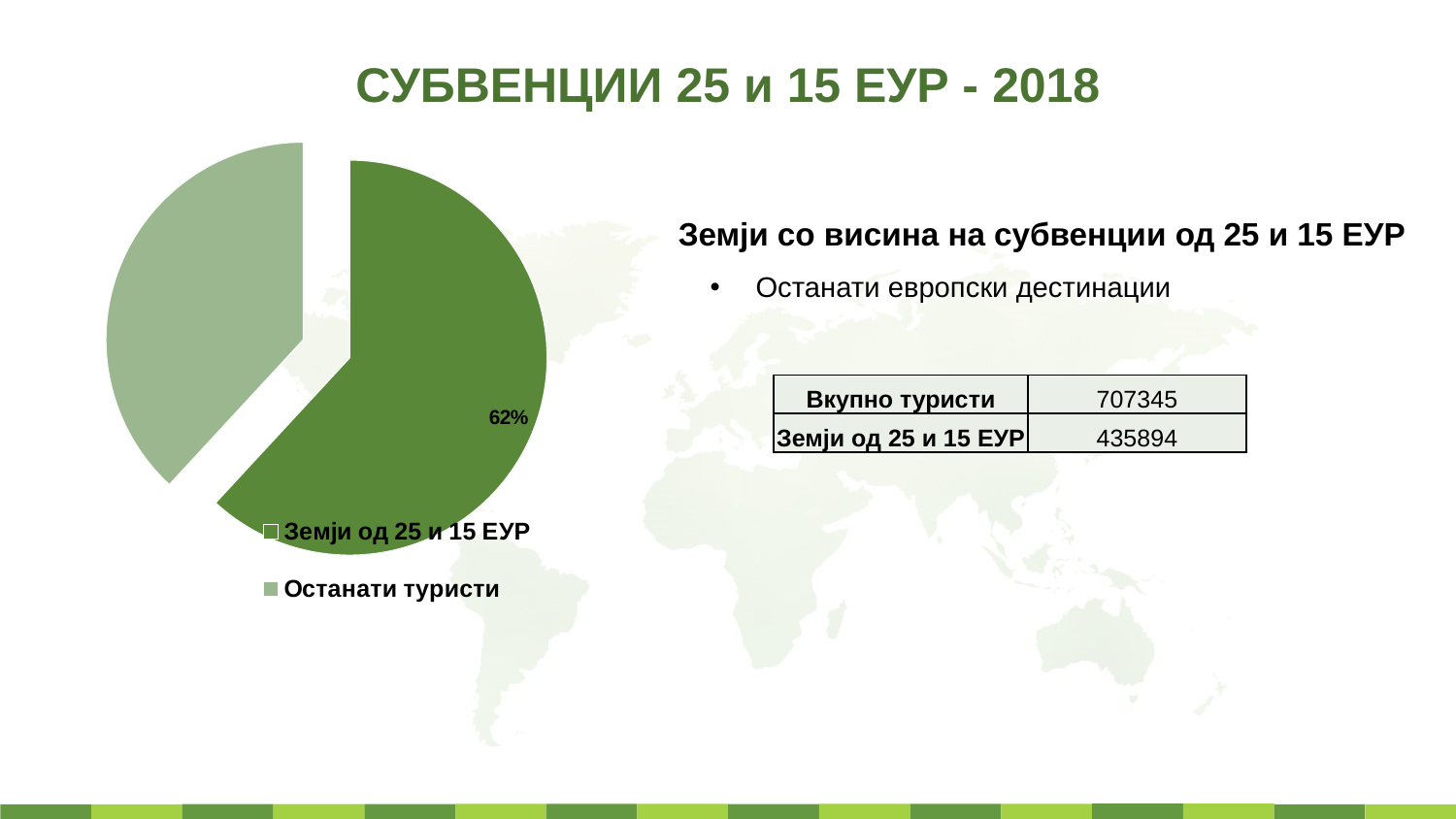
How many entries does the pie chart's legend list? 2 Which slice of the pie chart is the largest? Земји од 25 и 15 ЕУР What is the title of the slide containing the pie chart? СУБВЕНЦИИ 25 и 15 ЕУР - 2018 How many slices does the pie chart have? 2 What colour is the "Останати туристи" slice in the pie chart? light green Is the share of the "Земји од 25 и 15 ЕУР" slice in the pie chart greater or less than 50%? greater Which slice of the pie chart is the smallest? Останати туристи Is the share of the "Останати туристи" slice in the pie chart greater or less than 50%? less What percentage is shown for the slice "Земји од 25 и 15 ЕУР" in the pie chart? 62% What share of the pie does the "Земји од 25 и 15 ЕУР" slice represent? 62% Which slice is larger in the pie chart, "Земји од 25 и 15 ЕУР" or "Останати туристи"? Земји од 25 и 15 ЕУР What kind of chart is shown on the slide? pie chart